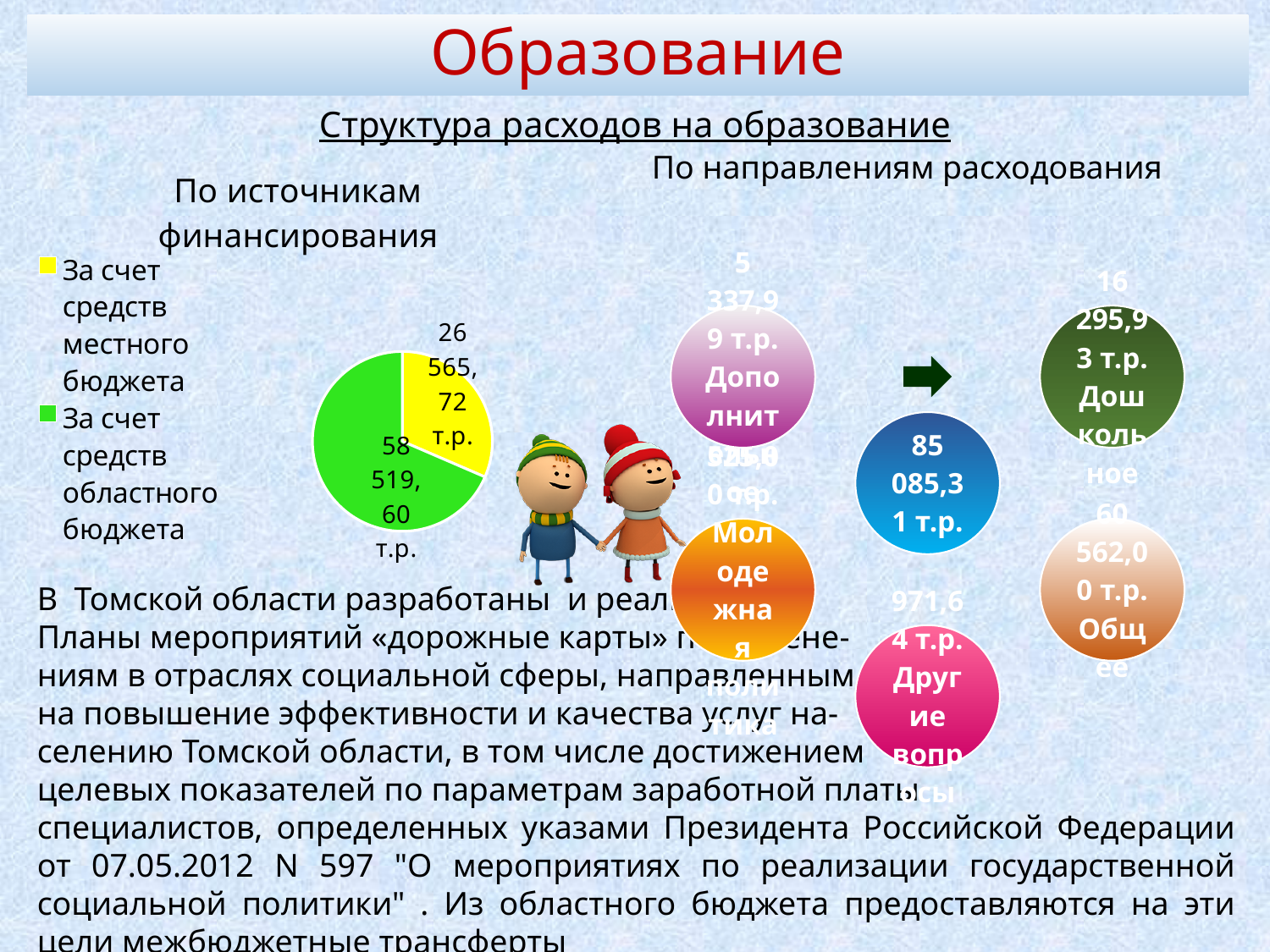
In the 'По источникам финансирования' pie chart, what colour is the slice for 'За счет средств областного бюджета'? green In the 'По источникам финансирования' pie chart, what colour is the slice for 'За счет средств местного бюджета'? yellow In the 'По источникам финансирования' pie chart, which source has the smallest share? За счет средств местного бюджета How many slices does the 'По источникам финансирования' pie chart have? 2 In the 'По источникам финансирования' pie chart, which is larger: the local budget (местного бюджета) value or the regional budget (областного бюджета) value? За счет средств областного бюджета In the 'По источникам финансирования' pie chart, what is the value for 'За счет средств областного бюджета'? 58 519,60 т.р. How many entries does the legend of the 'По источникам финансирования' pie chart list? 2 In the 'По источникам финансирования' pie chart, what is the value for 'За счет средств местного бюджета'? 26 565,72 т.р. In the 'По источникам финансирования' pie chart, which source has the largest share? За счет средств областного бюджета In the 'По источникам финансирования' pie chart, what is the difference between the regional budget value and the local budget value? 31 953,88 т.р. What kind of chart is the 'По источникам финансирования' chart? pie chart